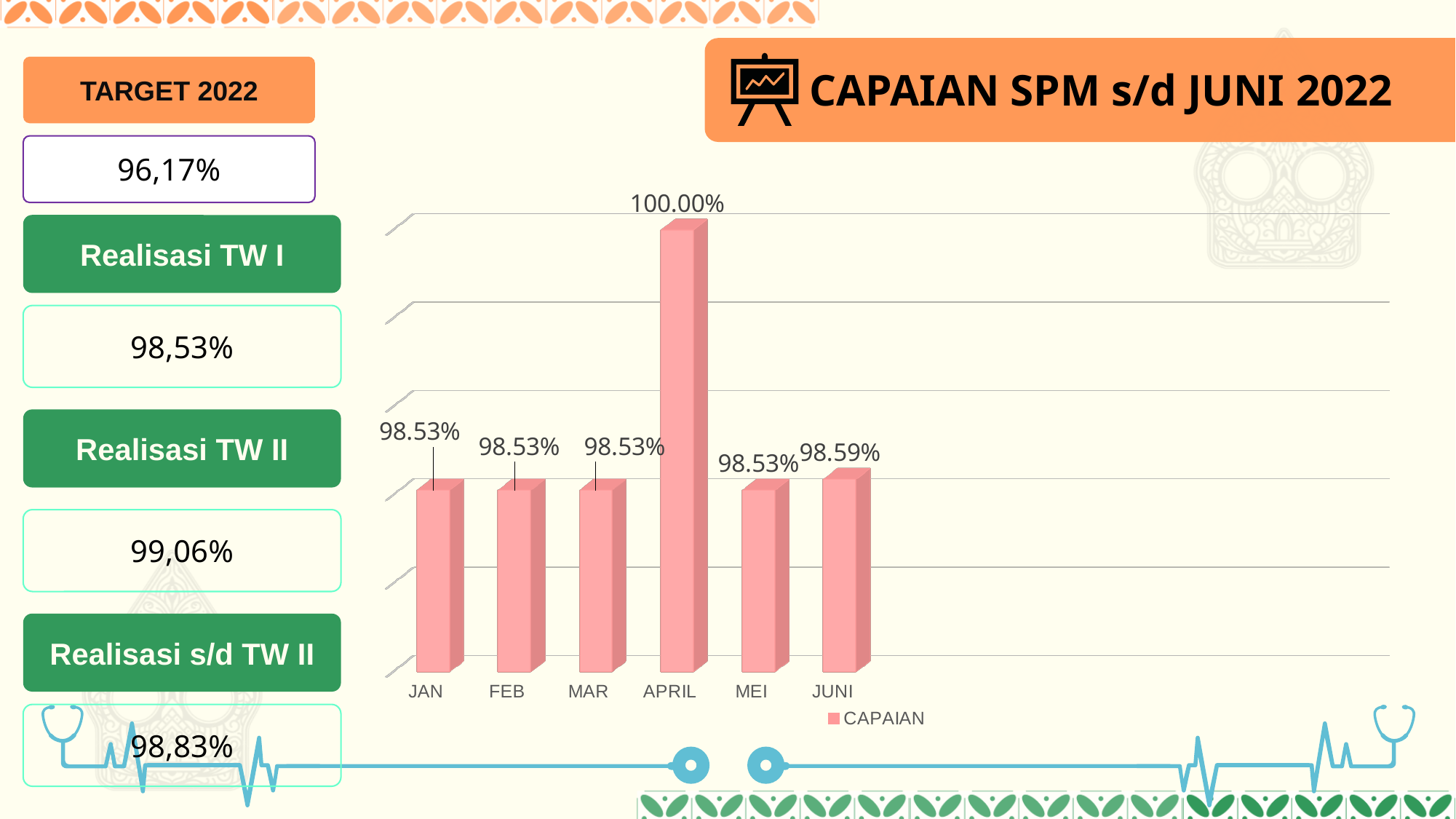
How many series does the chart legend list? 1 Which is larger, the value for APRIL or the value for FEB? APRIL What is the value for APRIL in the chart? 100.00% Which month has the highest value in the chart? APRIL What kind of chart is shown on the slide? Bar chart What is the name of the series shown in the chart legend? CAPAIAN What is the difference between the values for APRIL and JUNI? 1.41% How many months are shown on the x axis of the chart? 6 What is the difference between the values for APRIL and MAR? 1.47% What is the value for JAN in the chart? 98.53% What is the value for JUNI in the chart? 98.59% What is the value for MEI in the chart? 98.53%